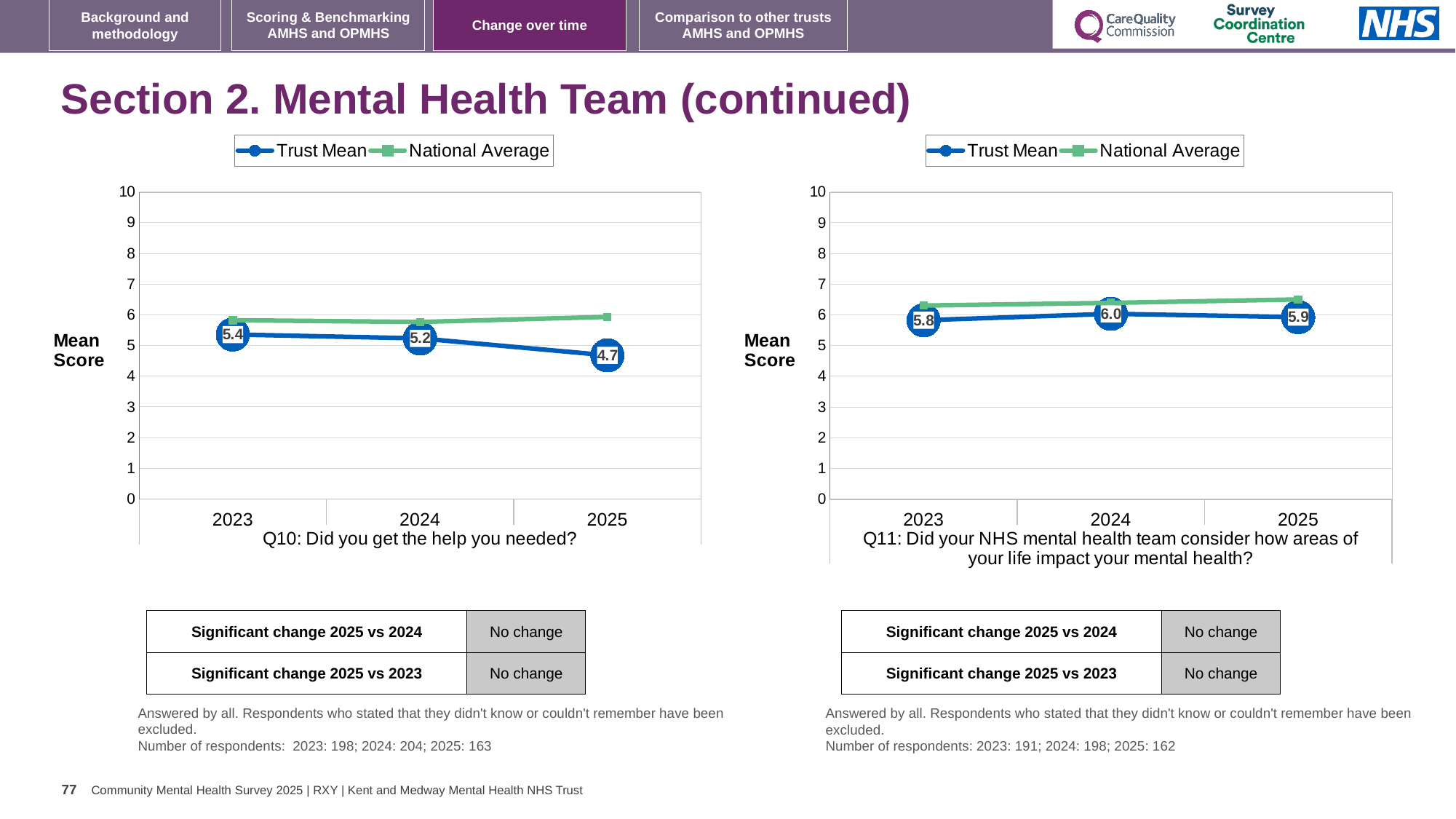
In the Q10 chart (left), what is the Trust Mean for 2023? 5.4 In the Q11 chart (right), which year has the lowest Trust Mean? 2023 In the Q10 chart (left), does the Trust Mean rise or fall from 2023 to 2025? fall What kind of chart is the Q10 chart (left)? line chart How many years are plotted on the x axis of the Q11 chart (right)? 3 How many series does the legend of the Q10 chart (left) list? 2 In the Q11 chart (right), what is the Trust Mean for 2024? 6.0 In the Q11 chart (right), is the Trust Mean for 2024 higher or lower than for 2023? higher In the Q10 chart (left), what is the Trust Mean for 2025? 4.7 In the Q10 chart (left), which year has the lowest Trust Mean? 2025 In the Q10 chart (left), what is the difference between the Trust Mean in 2023 and in 2025? 0.7 In the Q11 chart (right), is the National Average for 2025 greater or less than 6? greater